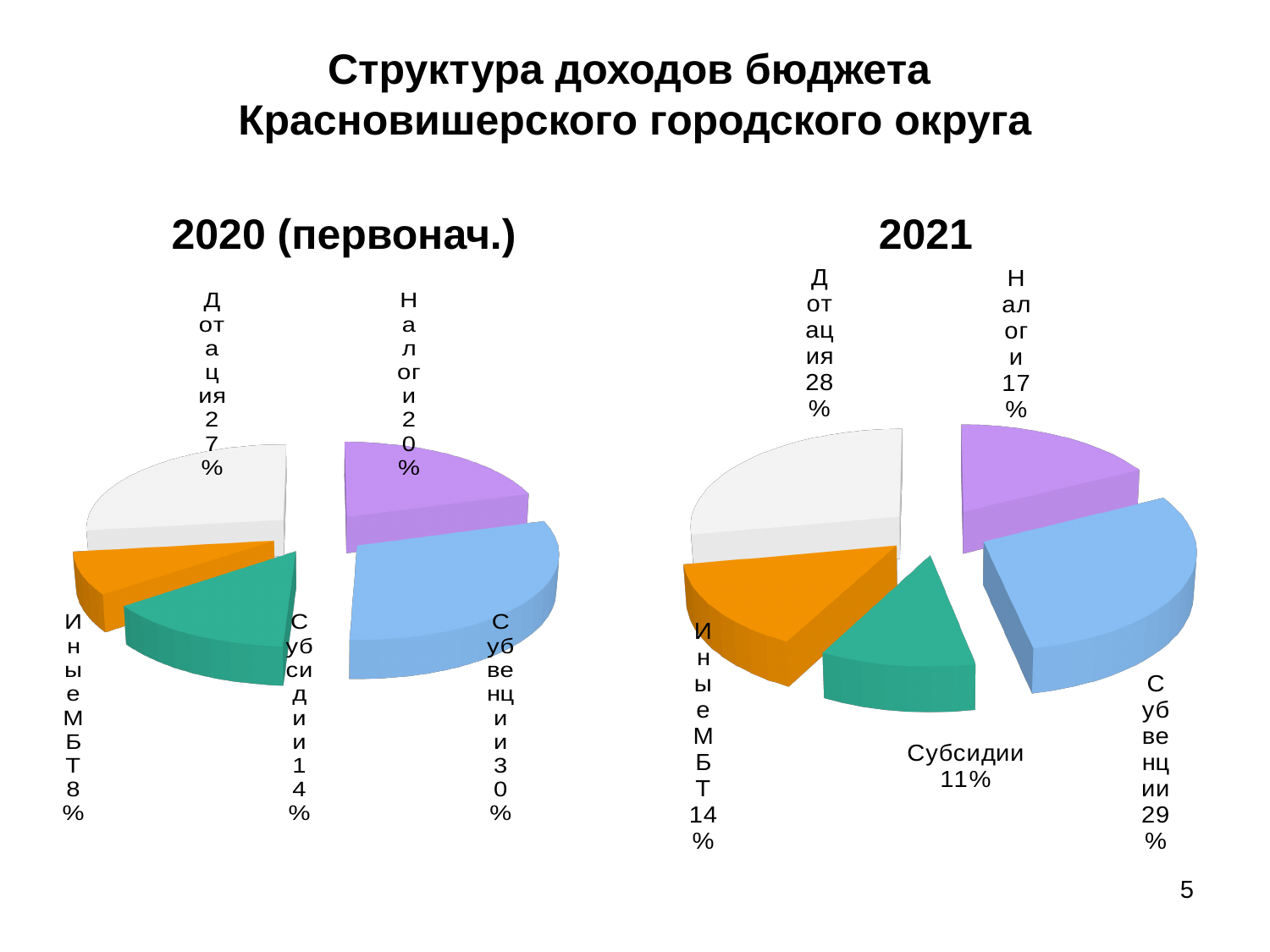
How many slices does the 2021 pie chart have? 5 In the 2020 (первонач.) chart, which category has the largest share? Субвенции In the 2021 chart, which is larger: Дотация or Налоги? Дотация In the 2021 chart, what share is Субсидии? 11% In the 2020 (первонач.) chart, what share is Дотация? 27% What is the difference between the Иные МБТ share in 2021 and in 2020 (первонач.)? 6% What type of chart is used for the 2020 (первонач.) data? Pie chart In the 2020 (первонач.) chart, which category has the smallest share? Иные МБТ In the 2020 (первонач.) chart, what share is Субвенции? 30% In the 2021 chart, what is the difference between the shares of Субвенции and Иные МБТ? 15% In the 2021 chart, what share is Налоги? 17% In the 2021 chart, which category has the smallest share? Субсидии